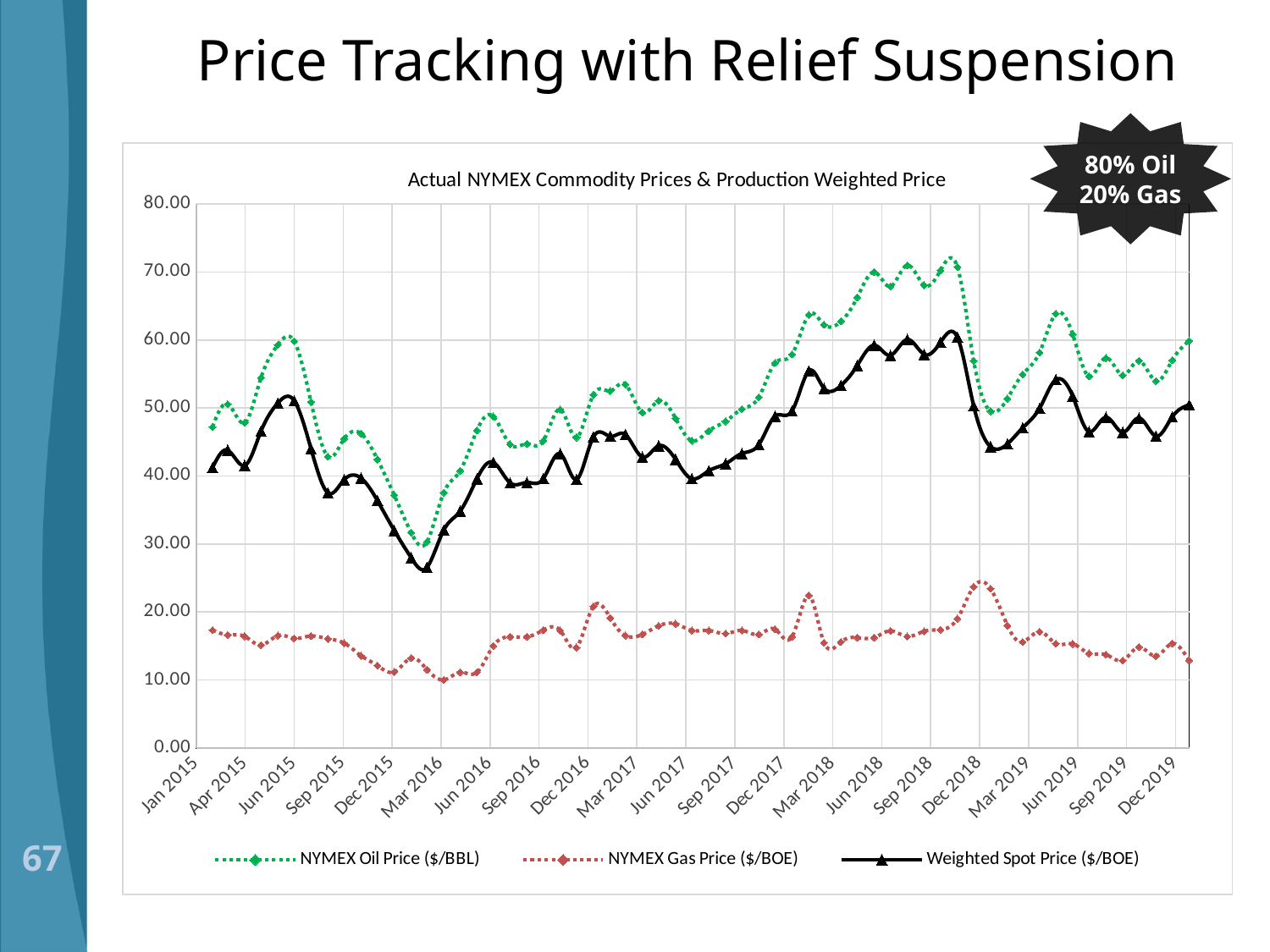
Does the NYMEX Oil Price rise or fall between Jun 2015 and Mar 2016? fall Which series has the lowest values across the whole chart? NYMEX Gas Price ($/BOE) What kind of chart is shown on the slide? line chart How many series does the chart's legend list? 3 What is the title of the chart? Actual NYMEX Commodity Prices & Production Weighted Price Is the NYMEX Gas Price around Mar 2016 greater or less than 20.00? less Is the Weighted Spot Price around Sep 2018 greater or less than 50.00? greater What are the three series named in the chart's legend? NYMEX Oil Price ($/BBL), NYMEX Gas Price ($/BOE), Weighted Spot Price ($/BOE) Which series has the highest values across the whole chart? NYMEX Oil Price ($/BBL) Around Sep 2018, which is larger: the NYMEX Oil Price or the Weighted Spot Price? NYMEX Oil Price Is the NYMEX Oil Price around Sep 2018 greater or less than 60.00? greater